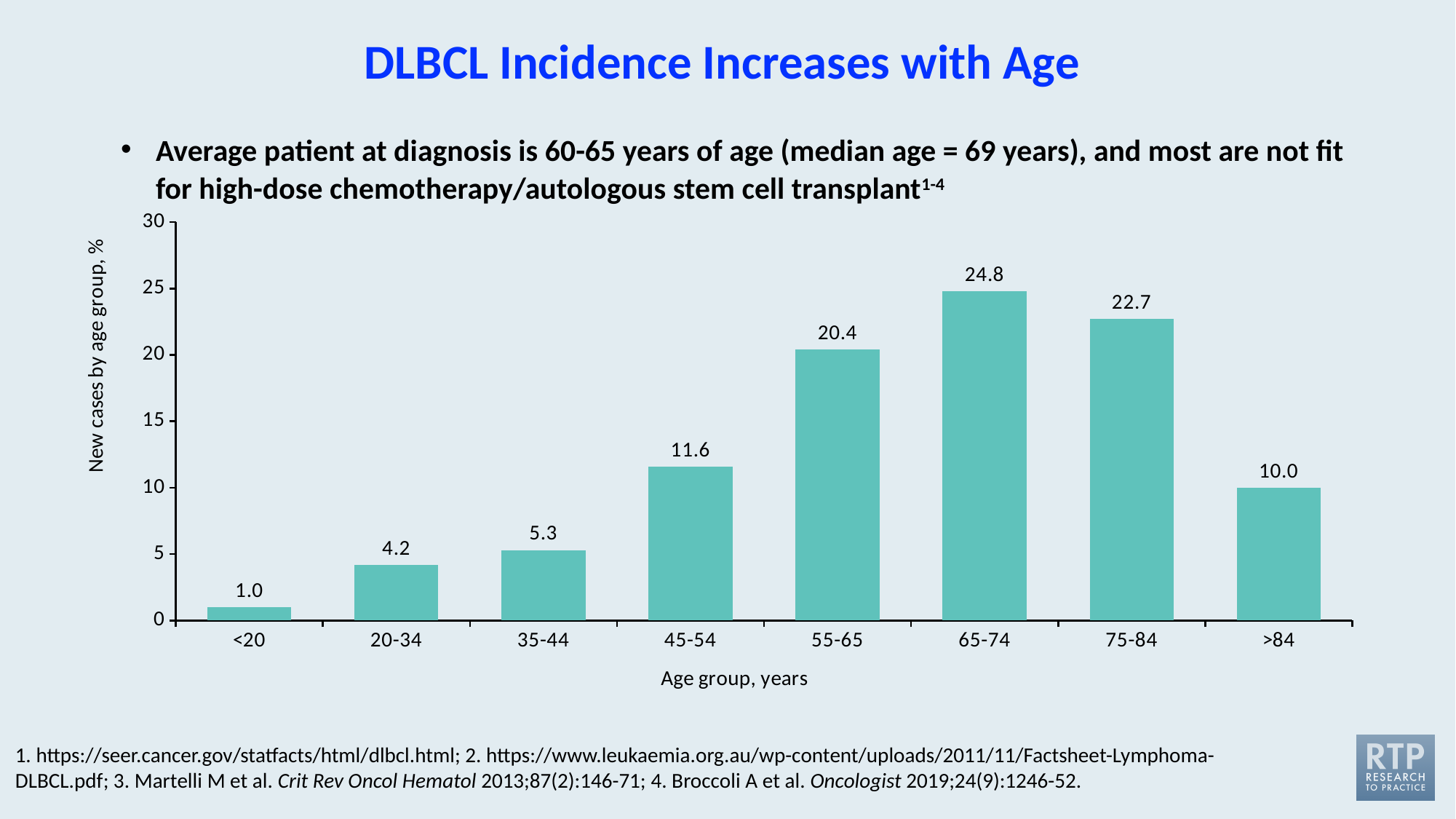
Which age group has the highest value? 65-74 How many age groups are shown on the x axis? 8 What is the difference between the values for the 55-65 and 45-54 age groups? 8.8 Which is larger, the value for 20-34 or the value for 35-44? 35-44 What is the value for the 45-54 age group? 11.6 What is the value for the <20 age group? 1.0 What is the difference between the values for the 65-74 and 75-84 age groups? 2.1 Is the value for the >84 age group greater or less than 15? less Which age group has the lowest value? <20 What is the label of the y axis? New cases by age group, % What is the value for the 65-74 age group? 24.8 What kind of chart is shown on the slide? bar chart